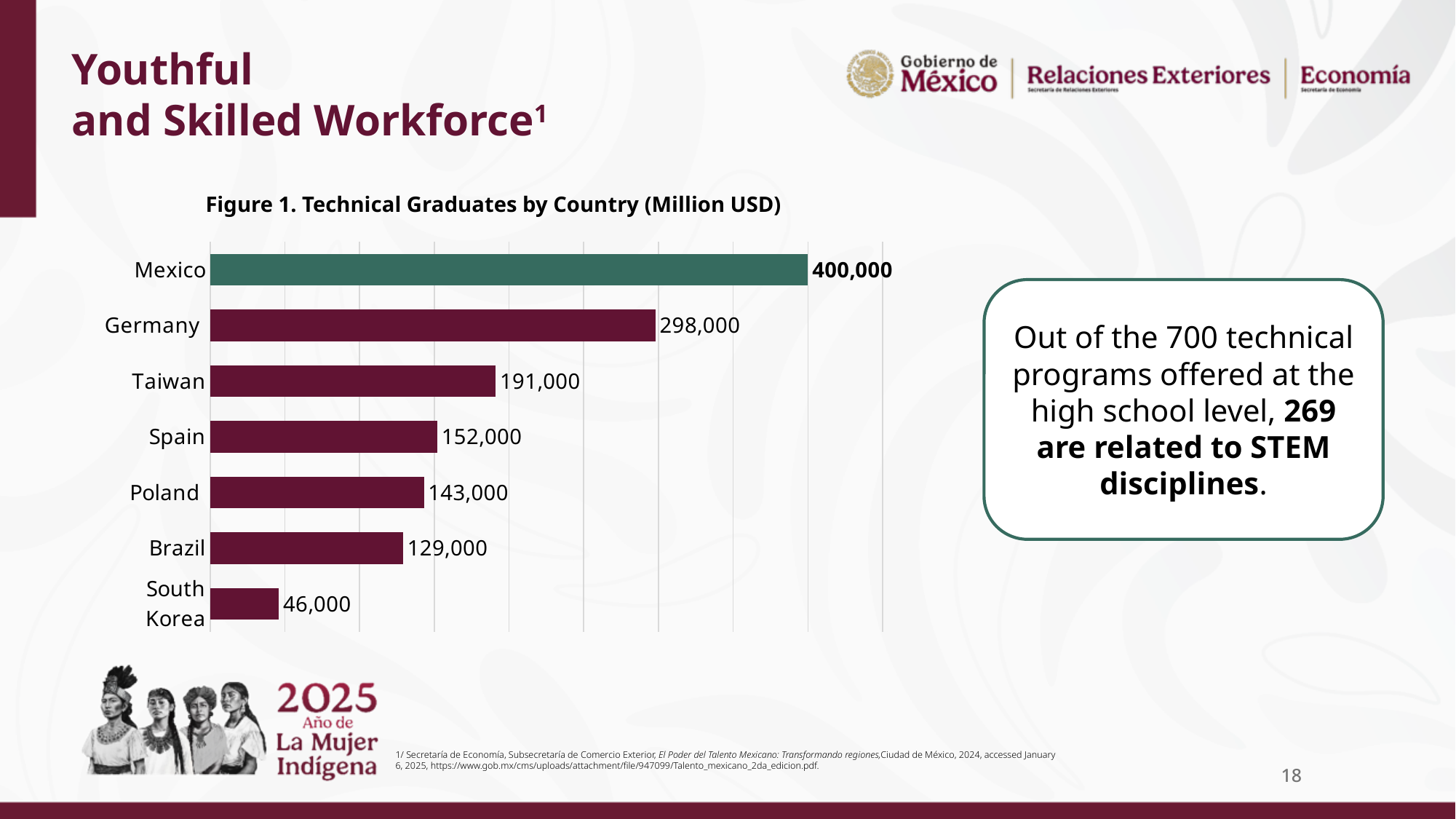
What is the difference between the values for Spain and Poland? 9,000 What is the title of the chart? Figure 1. Technical Graduates by Country (Million USD) What kind of chart is shown on the slide? Bar chart What is the value for Germany? 298,000 Which country has the lowest value? South Korea What is the value for Mexico in the Technical Graduates by Country chart? 400,000 How many countries are shown in the chart? 7 What is the value for Poland? 143,000 What is the difference between the values for Mexico and Germany? 102,000 Which country has the highest value? Mexico Which has a larger value, Taiwan or Brazil? Taiwan What is the value for South Korea? 46,000